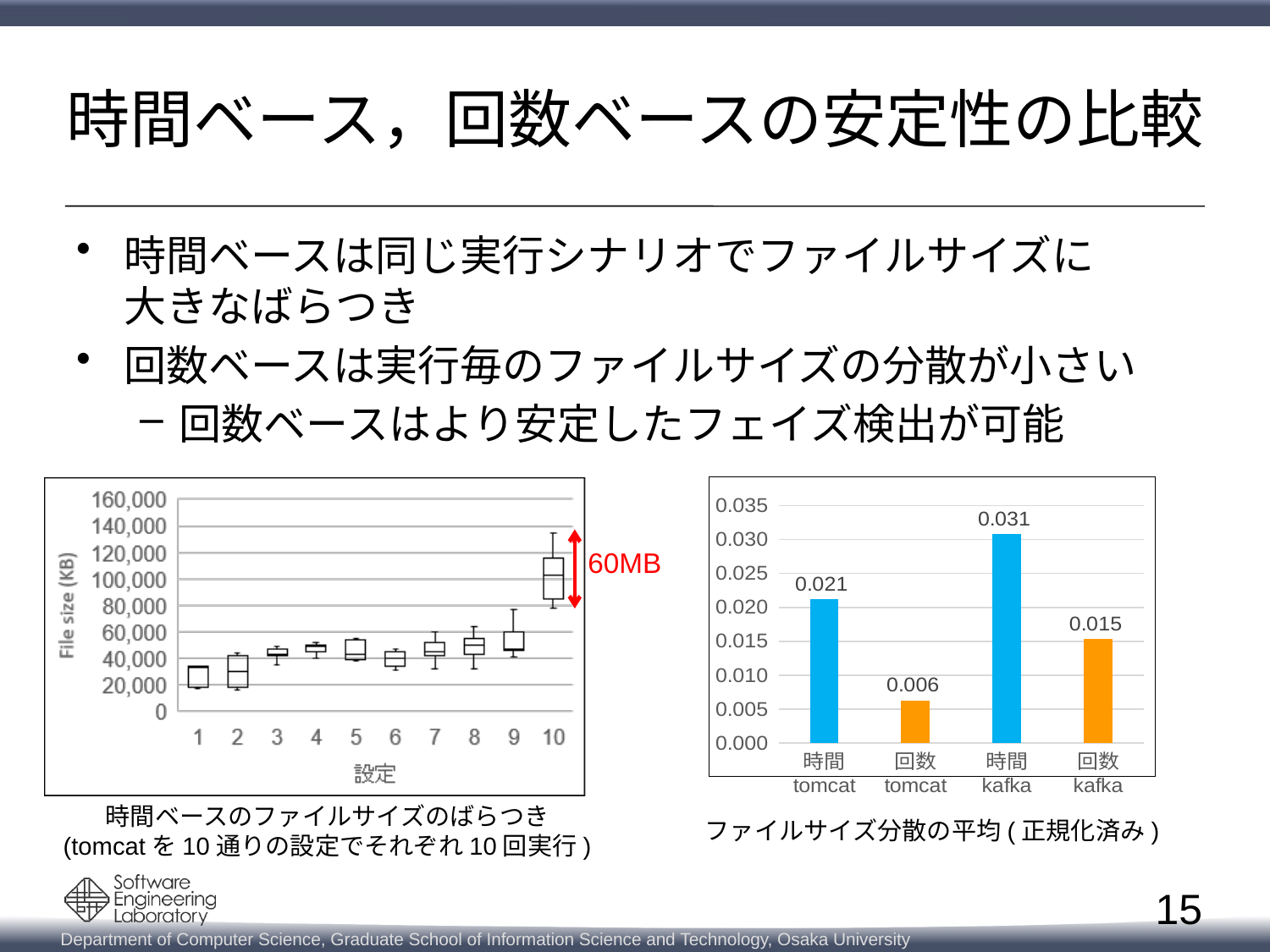
In the bar chart on the right, what is the value for 回数 kafka? 0.015 In the bar chart on the right, what is the value for 時間 tomcat? 0.021 How many bars are plotted in the bar chart on the right? 4 In the bar chart on the right, which is larger: the value for 時間 tomcat or 回数 kafka? 時間 tomcat What kind of chart is the chart on the right of the slide? Bar chart In the bar chart on the right, which category has the lowest value? 回数 tomcat In the bar chart on the right, which category has the highest value? 時間 kafka In the box plot on the left, how many settings (設定) are shown on the x axis? 10 In the bar chart on the right, what is the value for 回数 tomcat? 0.006 In the box plot on the left, is the median file size for setting 10 greater or less than 80,000? greater In the bar chart on the right, what is the difference between the values for 時間 kafka and 回数 kafka? 0.016 In the bar chart on the right, what is the value for 時間 kafka? 0.031